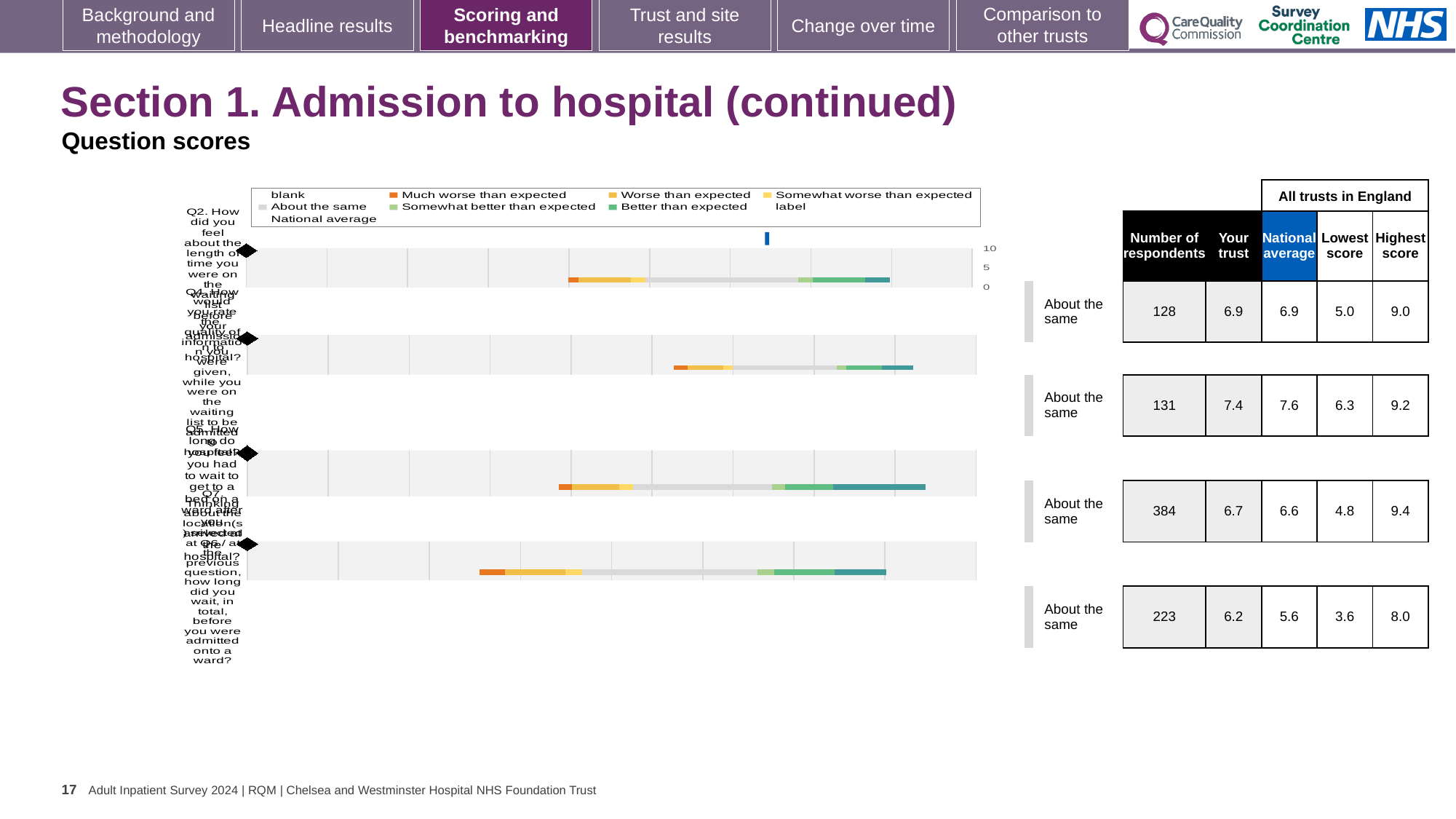
What is the smallest 'Lowest score' value shown in the table? 3.6 How many question rows (bars) are plotted in the chart? 4 In the table, what is the 'Your trust' score for the row with 384 respondents? 6.7 For the first row (128 respondents), what is the difference between the highest score and the lowest score? 4.0 What kind of chart is shown on the slide? Bar chart What colour does the legend use for 'Much worse than expected'? Orange In the table next to the chart, what is the number of respondents for the first row? 128 In the table, what is the national average for the row with 131 respondents? 7.6 What benchmark category is shown for every question row on the slide? About the same For the row with 223 respondents, which is larger: the 'Your trust' score or the national average? Your trust Which row has the highest 'Highest score' value in the table? The row with 384 respondents (9.4) For the row with 223 respondents, what is the difference between the 'Your trust' score and the national average? 0.6